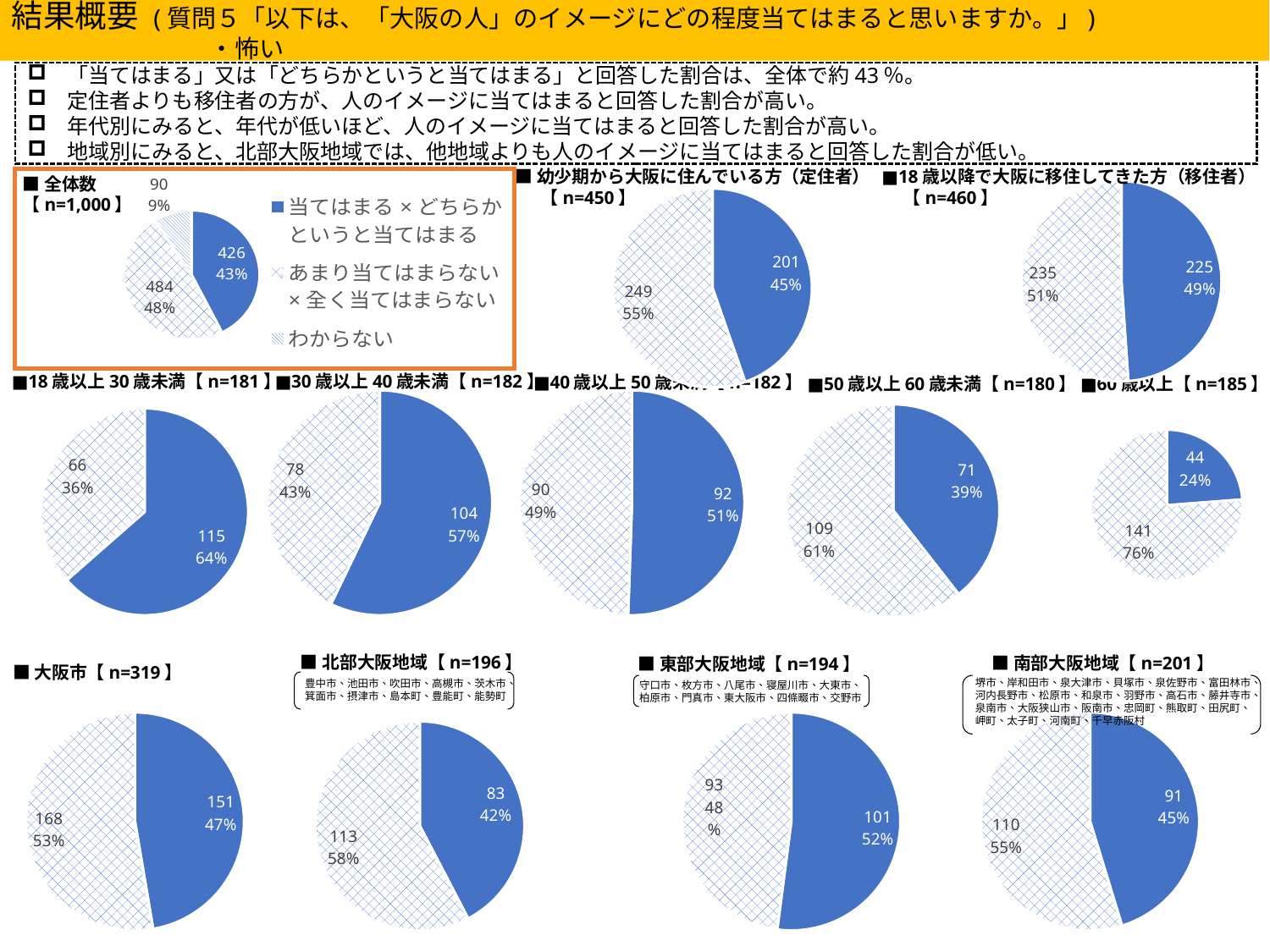
What kind of chart is used for 幼少期から大阪に住んでいる方（定住者）【n=450】? pie chart In the 全体数【n=1,000】 pie chart, what percentage share does わからない have? 9% In the 60歳以上【n=185】 pie chart, what is the difference between the two slice values (141 and 44)? 97 In the 東部大阪地域【n=194】 pie chart, what percentage is shown for the solid blue slice? 52% How many entries does the legend of the 全体数【n=1,000】 pie chart list? 3 In the 南部大阪地域【n=201】 pie chart, what is the value of the solid blue slice? 91 In the 50歳以上60歳未満【n=180】 pie chart, which slice is larger: the solid blue slice or the hatched slice? the hatched slice (109, 61%) How many slices does the 大阪市【n=319】 pie chart have? 2 In the 全体数【n=1,000】 pie chart, what is the value for 当てはまる×どちらかというと当てはまる? 426 In the 18歳以上30歳未満【n=181】 pie chart, what percentage is shown for the solid blue slice? 64% In the 北部大阪地域【n=196】 pie chart, what is the value of the hatched slice? 113 In the 18歳以降で大阪に移住してきた方（移住者）【n=460】 pie chart, what is the value of the solid blue slice? 225